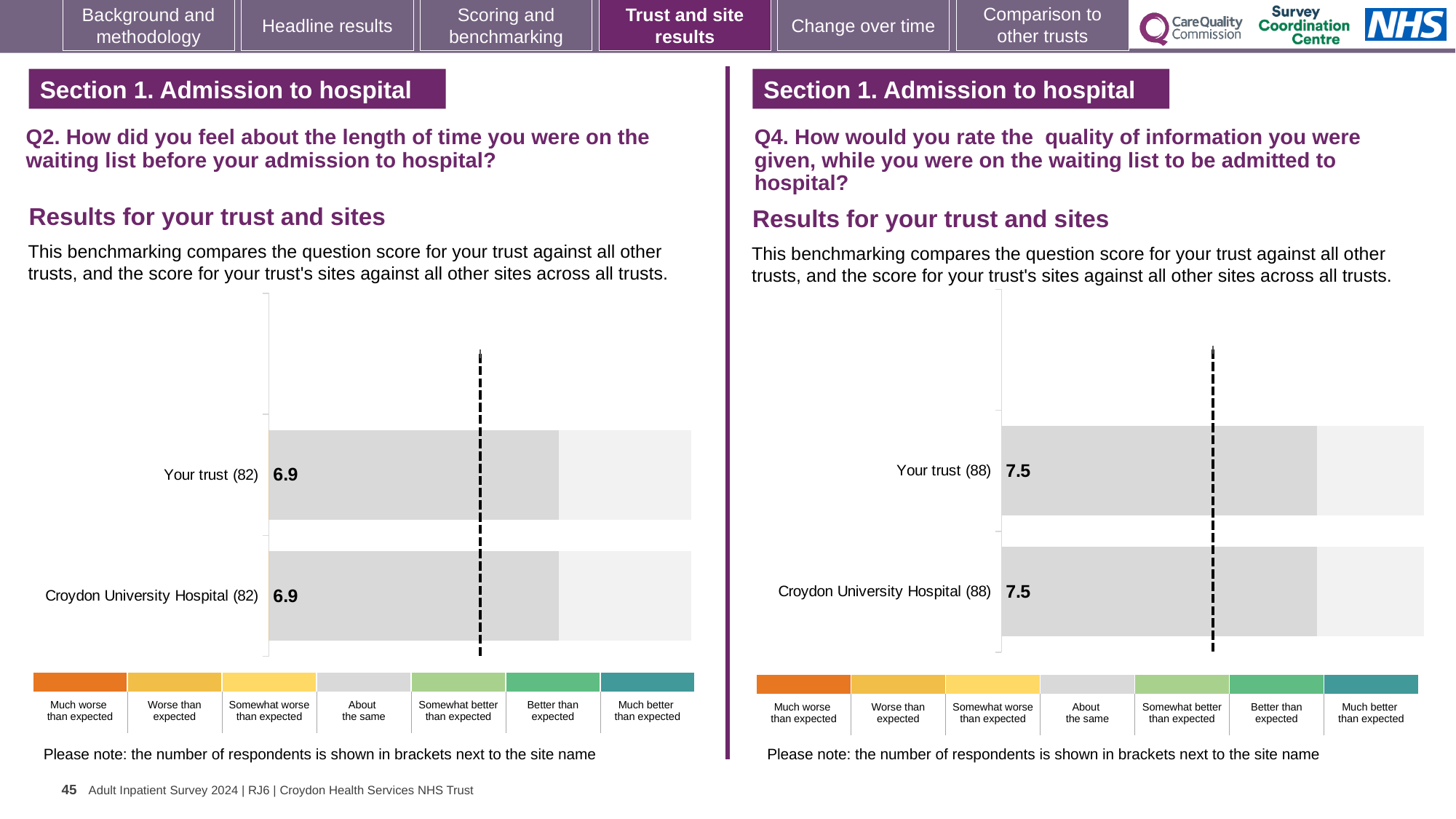
On the left chart (Q2), what is the difference between the score for Your trust and the score for Croydon University Hospital? 0.0 How many bars are plotted on the left chart (Q2)? 2 On the left chart (Q2), which benchmark category does the grey shading of the bars correspond to in the colour key? About the same On the left chart (Q2), how many respondents are shown in brackets for Your trust? 82 On the left chart (Q2), what is the score for Your trust? 6.9 What kind of chart is used on the left (Q2)? Bar chart On the right chart (Q4), what is the difference between the score for Your trust and the score for Croydon University Hospital? 0.0 How many bars are plotted on the right chart (Q4)? 2 On the right chart (Q4), what is the score for Croydon University Hospital? 7.5 On the right chart (Q4), how many respondents are shown in brackets for Croydon University Hospital? 88 On the left chart (Q2), what is the score for Croydon University Hospital? 6.9 On the right chart (Q4), what is the score for Your trust? 7.5